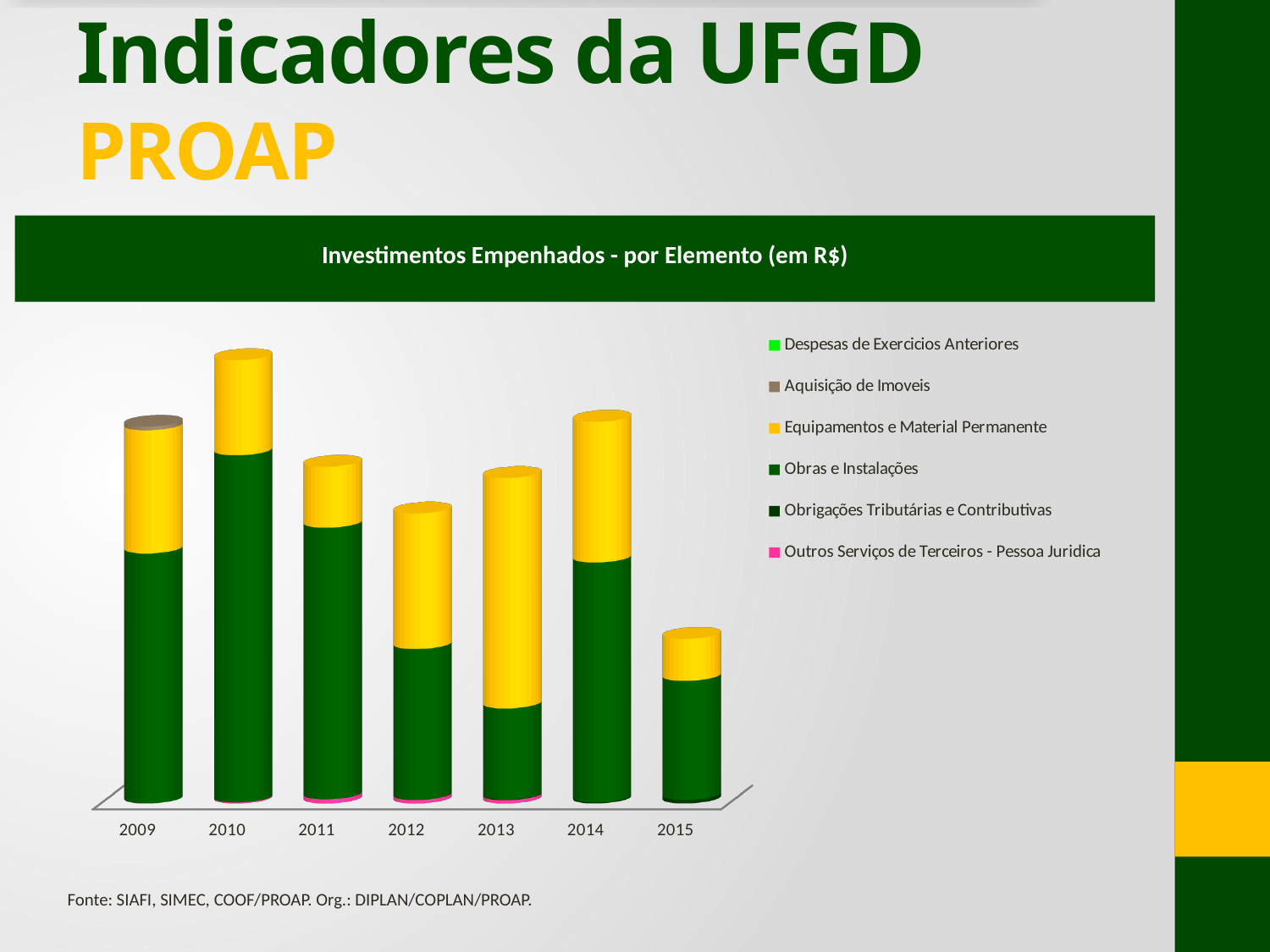
Which year is the only one showing an 'Aquisição de Imoveis' (brown) segment? 2009 Does the total investment rise or fall from 2014 to 2015? Fall How many series does the chart legend list? 6 What kind of chart is shown on the slide? Stacked bar chart Which year has the shortest total bar? 2015 Which year has the tallest total bar? 2010 Which year has the largest 'Obras e Instalações' (green) segment? 2010 Is the total bar for 2014 taller or shorter than the total bar for 2012? Taller How many years are shown on the x axis of the chart? 7 Which year has the smallest 'Obras e Instalações' (green) segment? 2013 Which year has the largest 'Equipamentos e Material Permanente' (yellow) segment? 2013 What is the title of the chart? Investimentos Empenhados - por Elemento (em R$)